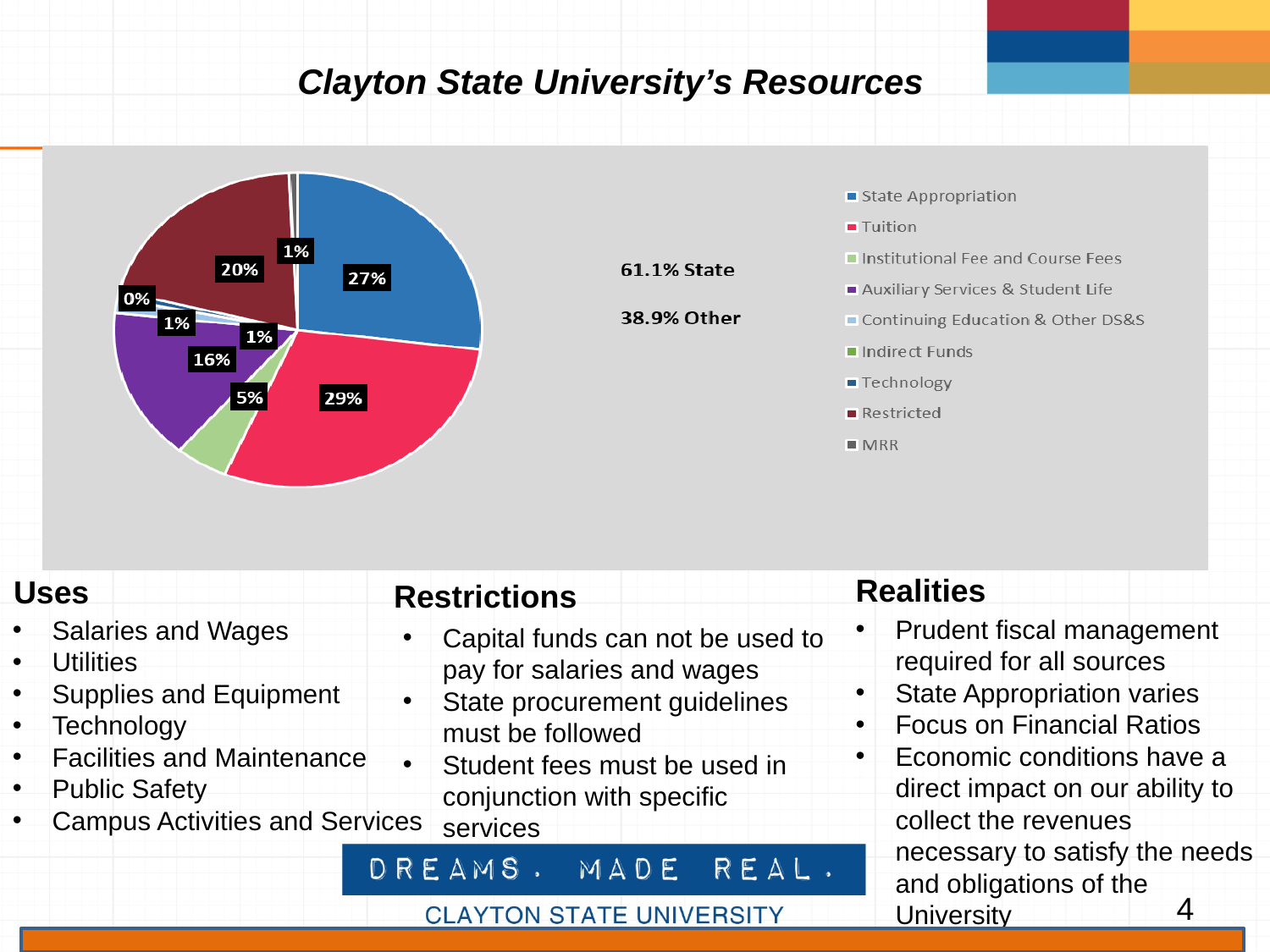
What percentage is shown for Auxiliary Services & Student Life? 16% What percentage of resources comes from State Appropriation? 27% What percentage of Clayton State University's resources comes from Tuition? 29% Which is larger, the Restricted slice or the Auxiliary Services & Student Life slice? Restricted According to the text beside the pie chart, what percentage of resources is State? 61.1% Which resource category has the smallest slice, labelled 0%? Technology What percentage is shown for Institutional Fee and Course Fees? 5% Which resource category has the largest slice of the pie? Tuition How many categories does the pie chart's legend list? 9 How many percentage points larger is Tuition than State Appropriation? 2 What share of the pie is Restricted? 20% What type of chart is shown on the slide? pie chart